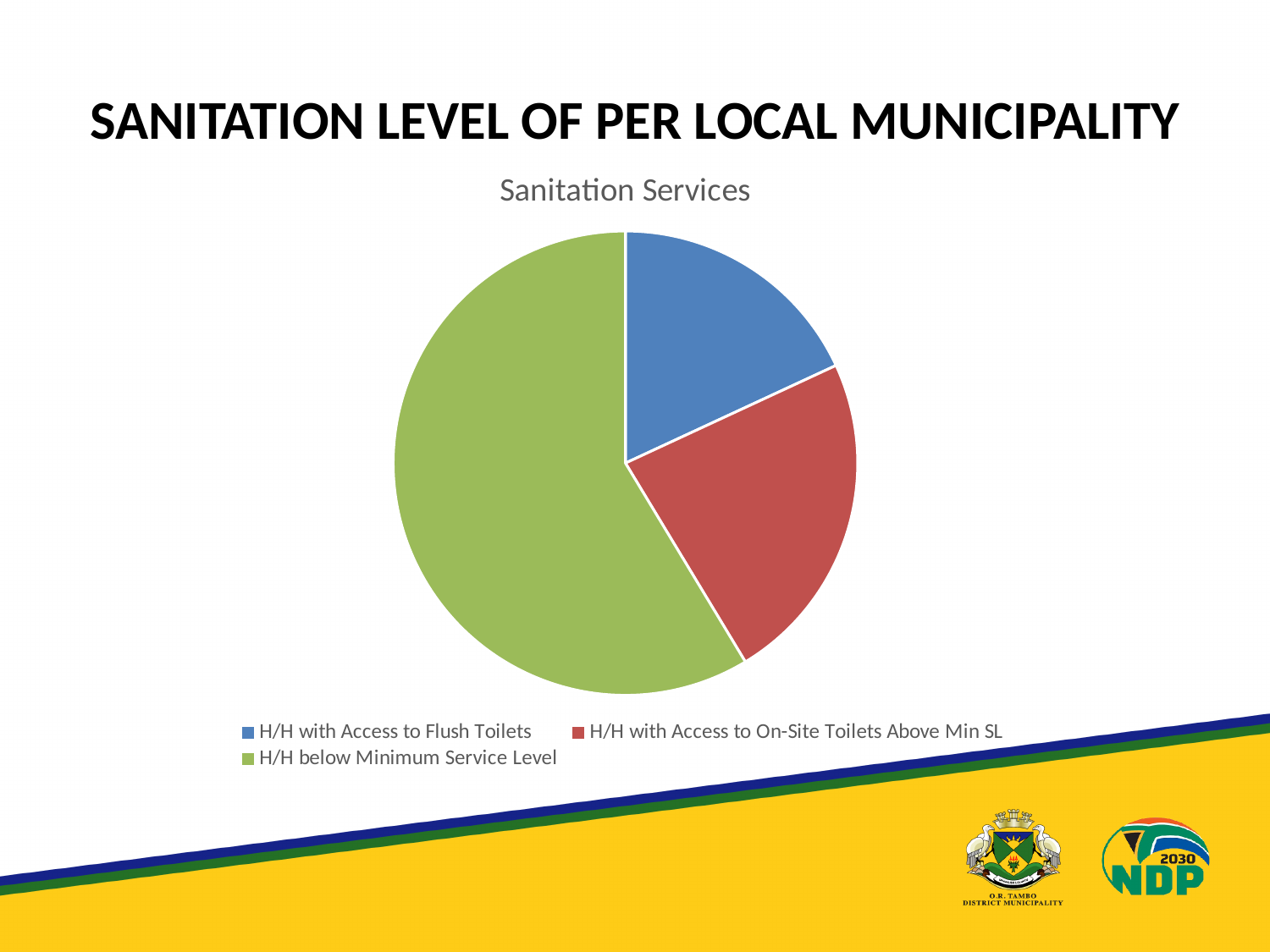
What is the title of the chart? Sanitation Services How many slices does the pie chart have? 3 What kind of chart is shown on the slide? pie chart Which slice is larger: H/H below Minimum Service Level or H/H with Access to On-Site Toilets Above Min SL? H/H below Minimum Service Level How many entries does the legend list? 3 Which colour represents H/H below Minimum Service Level in the pie chart? green Does the H/H below Minimum Service Level slice make up more or less than half of the pie? more Which category has the smallest slice of the pie? H/H with Access to Flush Toilets Which slice is larger: H/H with Access to Flush Toilets or H/H with Access to On-Site Toilets Above Min SL? H/H with Access to On-Site Toilets Above Min SL Which category has the largest slice of the pie? H/H below Minimum Service Level